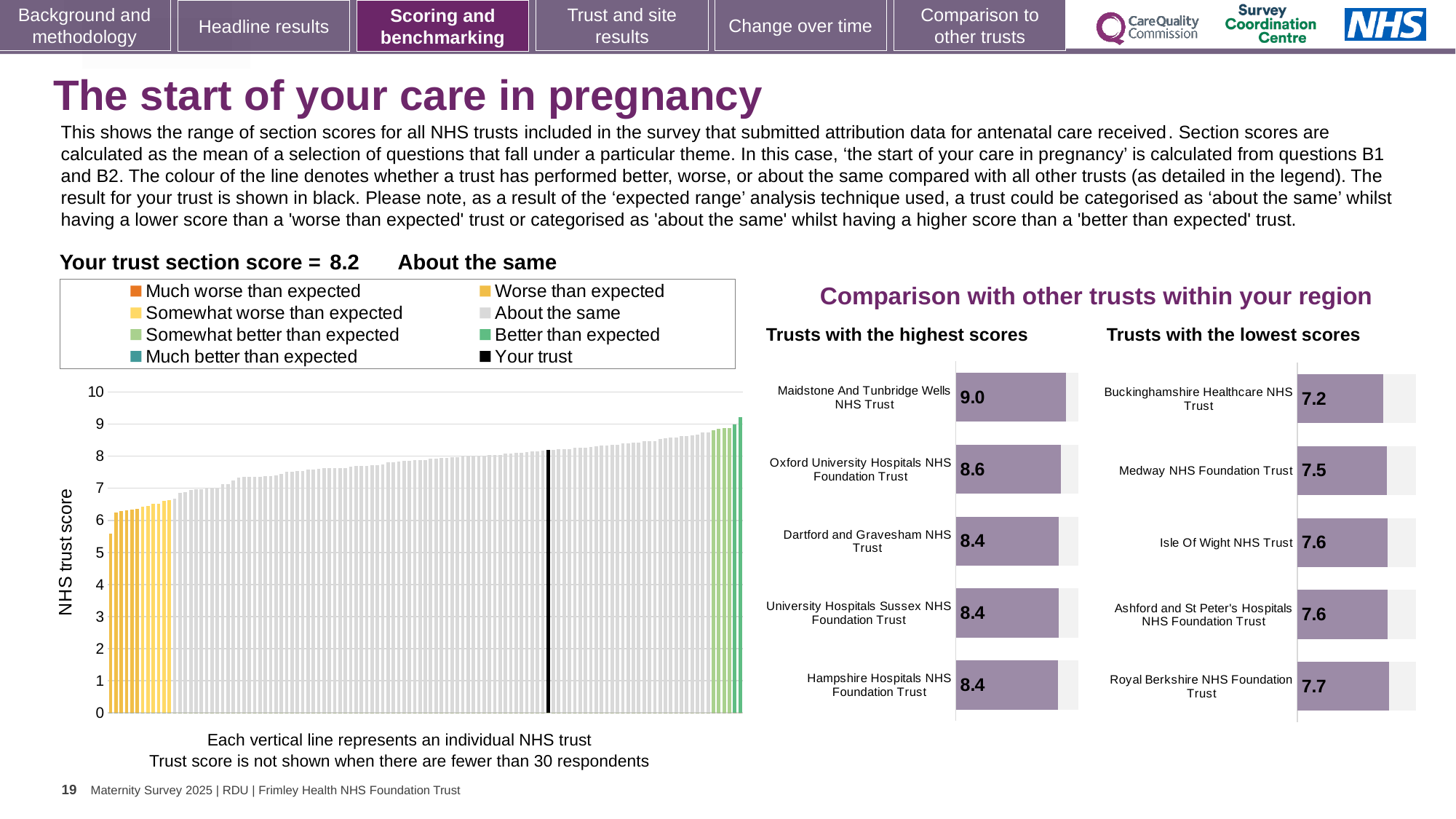
How many trusts are shown on the 'Trusts with the lowest scores' chart? 5 On the 'Trusts with the highest scores' chart, what is the difference between the scores of Maidstone And Tunbridge Wells NHS Trust and Oxford University Hospitals NHS Foundation Trust? 0.4 On the 'Trusts with the highest scores' chart, what is the score for Maidstone And Tunbridge Wells NHS Trust? 9.0 On the 'Trusts with the highest scores' chart, which trust has the highest score? Maidstone And Tunbridge Wells NHS Trust On the 'Trusts with the lowest scores' chart, what is the score for Royal Berkshire NHS Foundation Trust? 7.7 How many entries does the legend above the large chart on the left list? 8 On the 'Trusts with the lowest scores' chart, which has the larger score: Medway NHS Foundation Trust or Isle Of Wight NHS Trust? Isle Of Wight NHS Trust On the large chart on the left, do the trust scores rise or fall from left to right? rise On the 'Trusts with the highest scores' chart, what is the score for Oxford University Hospitals NHS Foundation Trust? 8.6 On the 'Trusts with the lowest scores' chart, which trust has the lowest score? Buckinghamshire Healthcare NHS Trust On the 'Trusts with the lowest scores' chart, what is the score for Buckinghamshire Healthcare NHS Trust? 7.2 On the large chart on the left, what is the section score for your trust (the black bar)? 8.2